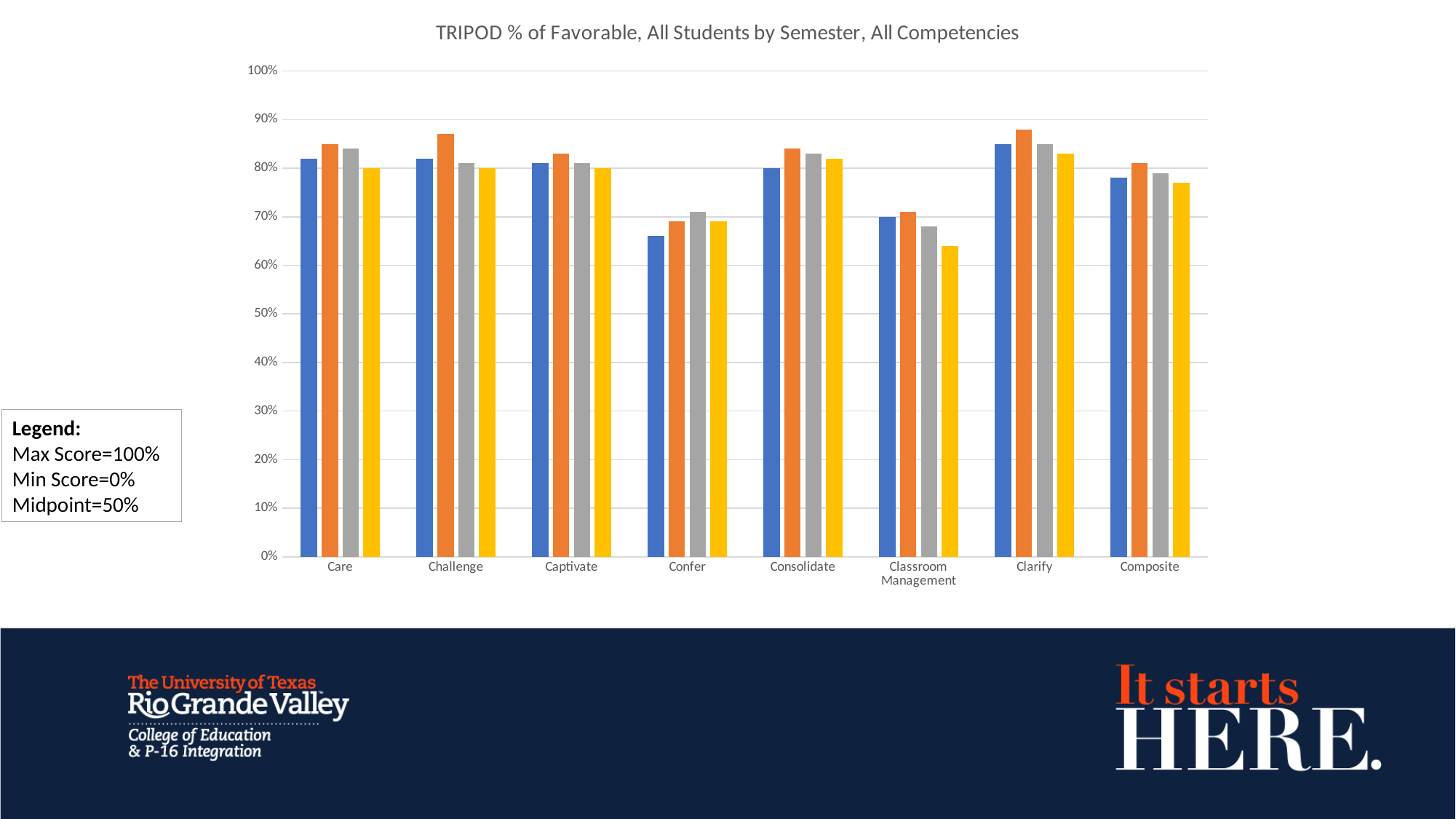
Is the value of the orange bar for Challenge greater or less than 80%? greater Within the Challenge category, which coloured bar is the highest? orange Is the value of the yellow bar for Classroom Management greater or less than 70%? less Which is larger, the blue bar for Care or the blue bar for Confer? Care What is the title of the chart? TRIPOD % of Favorable, All Students by Semester, All Competencies How many bars are plotted for each category in the chart? 4 Is the value of the yellow bar for Composite greater or less than 80%? less How many competency categories are shown on the x axis of the chart? 8 Within the Classroom Management category, which coloured bar is the lowest? yellow What kind of chart is shown on the slide? bar chart